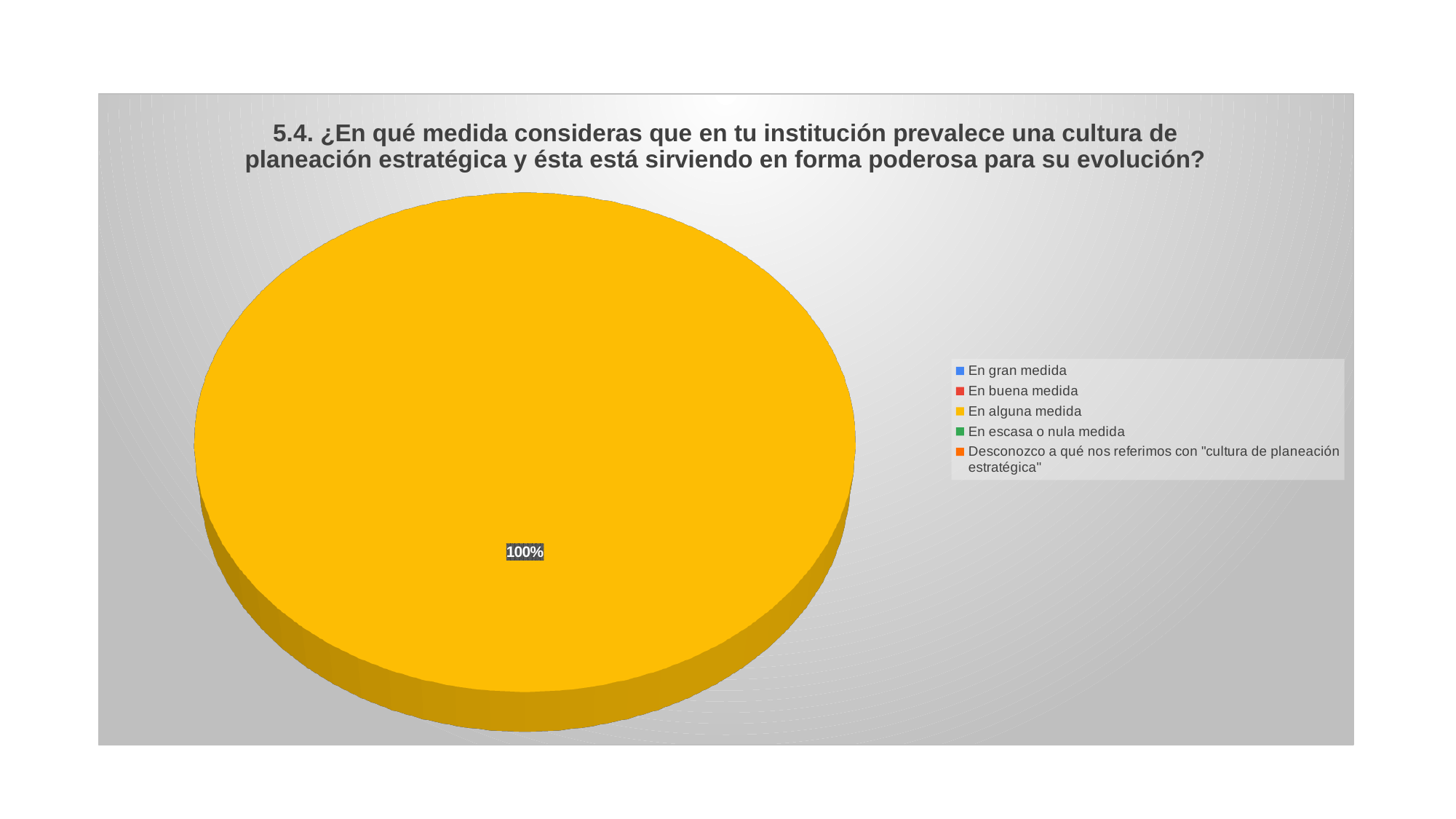
What colour is the slice for "En alguna medida"? yellow What value is printed as the data label on the pie? 100% Is the share for "En alguna medida" larger than the share for "En gran medida"? Yes How many entries does the legend list? 5 How many slices are visible in the pie? 1 Which legend entry is shown with a green marker? En escasa o nula medida What kind of chart is shown on the slide? pie chart Which category accounts for the entire pie? En alguna medida What share of the pie does "En alguna medida" hold? 100%